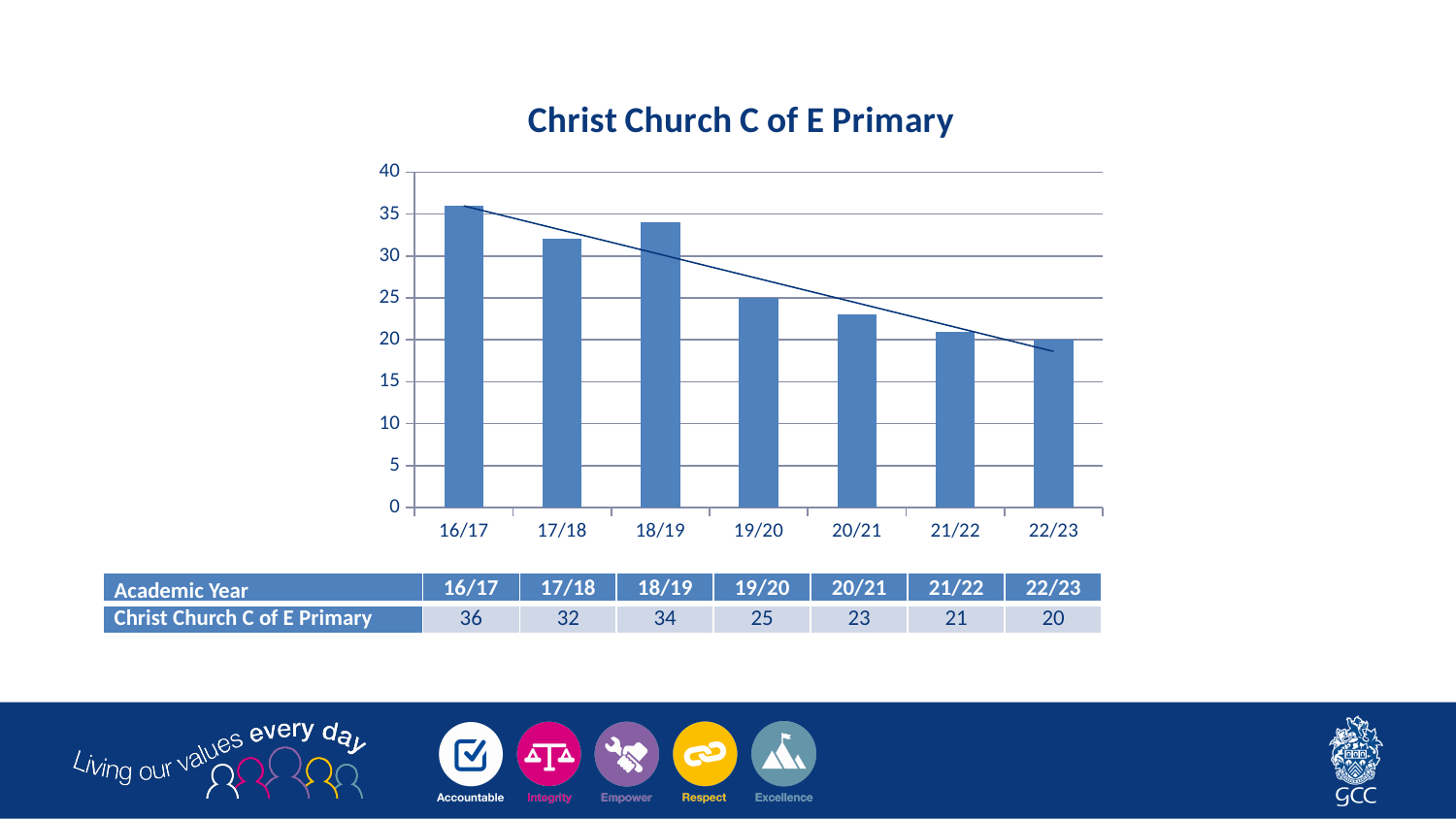
Which is larger, the value for 17/18 or the value for 18/19? 18/19 Do the values generally rise or fall from 16/17 to 22/23? fall What kind of chart is shown on the slide? bar chart What is the value for 16/17? 36 Which academic year has the highest value? 16/17 How many academic years are shown on the x axis? 7 What is the value for 19/20? 25 Which academic year has the lowest value? 22/23 What is the value for 22/23? 20 What is the difference between the values for 16/17 and 22/23? 16 Is the value for 20/21 greater or less than 25? less What is the difference between the values for 17/18 and 18/19? 2